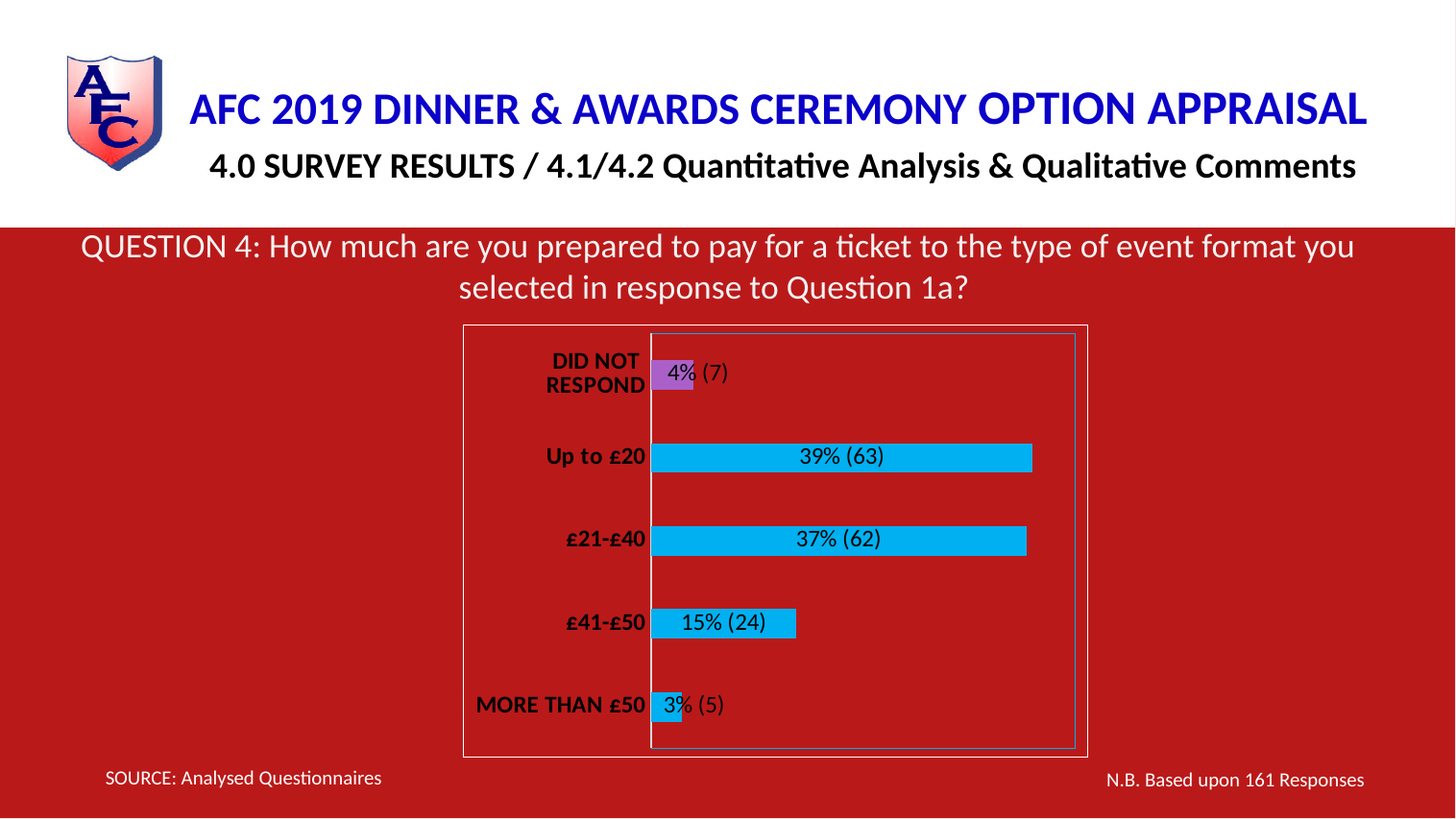
How many respondents did not respond to Question 4? 7 What is the difference in percentage points between £41-£50 and MORE THAN £50? 12 What is the difference in number of respondents between Up to £20 and £21-£40? 1 What kind of chart is shown on the slide? Bar chart Which is larger, the value for £41-£50 or the value for DID NOT RESPOND? £41-£50 Which bar is coloured differently from the others? DID NOT RESPOND How many respondents chose the £21-£40 range? 62 What is the value shown for the £41-£50 category? 15% (24) Which category has the highest value? Up to £20 Which category has the lowest value? MORE THAN £50 What percentage of respondents are prepared to pay up to £20? 39% How many categories are shown in the chart? 5